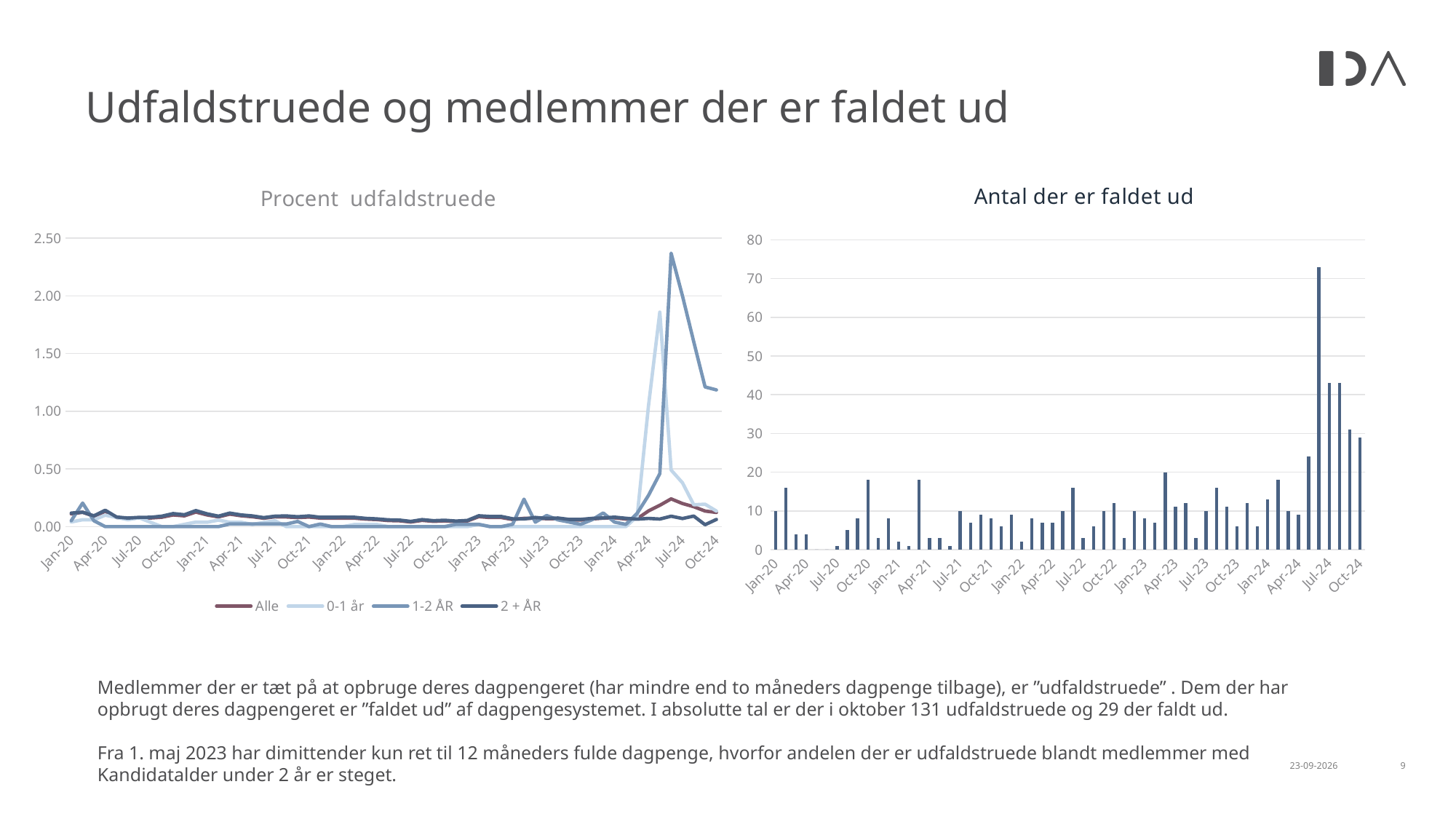
In the "Antal der er faldet ud" chart, is the value for Jul-24 greater or less than 60? less In the "Procent udfaldstruede" chart, is the peak value of the 0-1 år series greater or less than 1.50? greater What kind of chart is the chart titled "Procent udfaldstruede"? line chart In the "Procent udfaldstruede" chart, which series reaches the highest peak? 1-2 ÅR In the "Antal der er faldet ud" chart, which month has the highest bar? Jun-24 In the "Procent udfaldstruede" chart, is the peak value of the 1-2 ÅR series greater or less than 2.00? greater How many series does the legend of the "Procent udfaldstruede" chart list? 4 What is the title of the chart on the right side of the slide? Antal der er faldet ud In the "Antal der er faldet ud" chart, which is larger, the value for Jul-24 or the value for Oct-24? Jul-24 What kind of chart is the chart titled "Antal der er faldet ud"? bar chart In the "Antal der er faldet ud" chart, do the values generally rise or fall from Jan-24 to Jul-24? rise